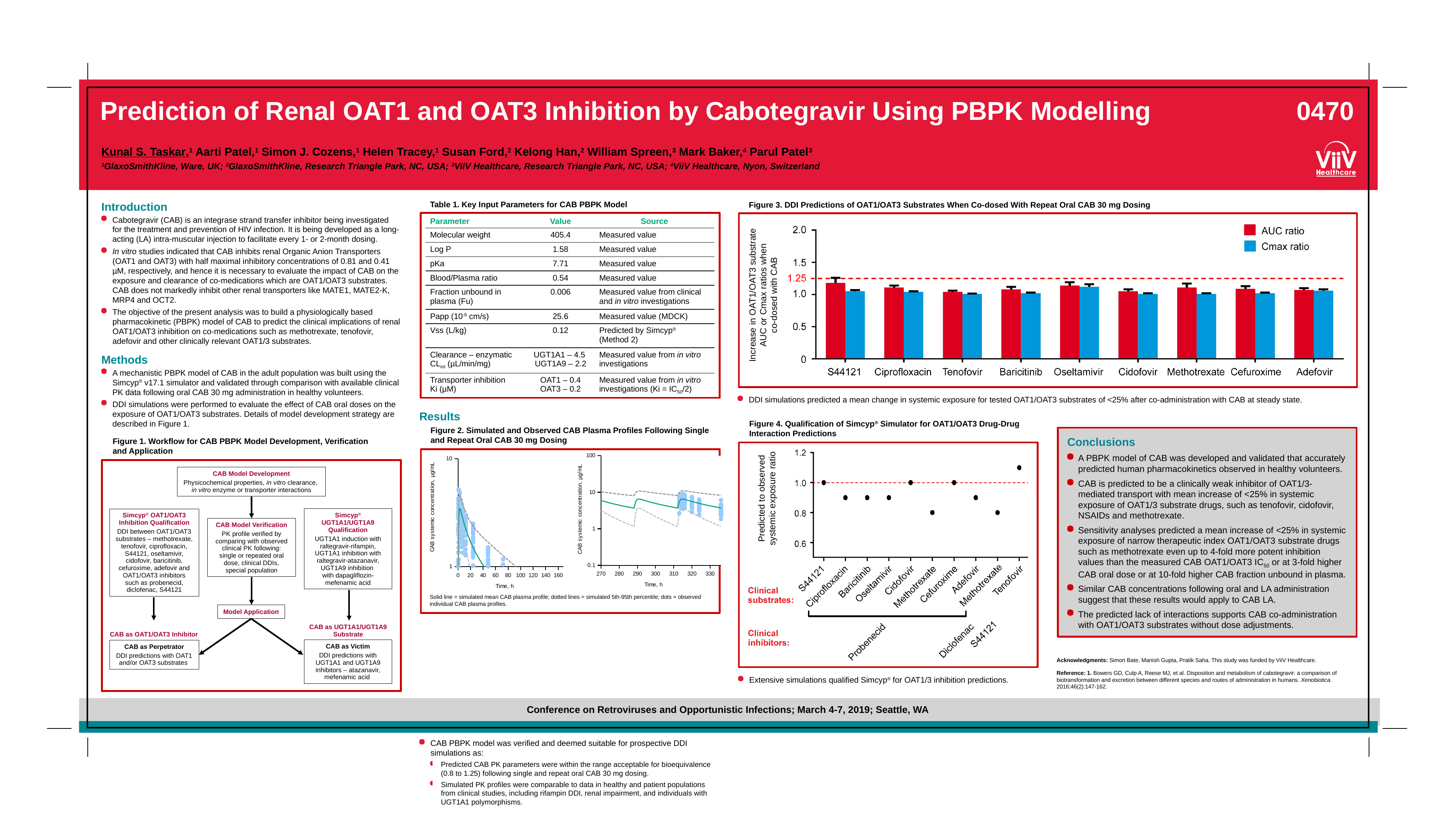
In Figure 4, which substrate has the highest predicted to observed systemic exposure ratio? Tenofovir In Figure 3, what value does the red dashed horizontal line mark on the y axis? 1.25 In Figure 3, is the AUC ratio for S44121 greater or less than 1.5? less In Figure 3, which colour represents the Cmax ratio? blue In Figure 3, how many series does the legend list? 2 What kind of chart is Figure 3? bar chart In Figure 4, what is the predicted to observed systemic exposure ratio for Cidofovir? 1.0 In Figure 4, is the value for Tenofovir greater or less than 1.0? greater In Figure 4, how many data points are plotted? 10 In Figure 3, how many substrates are shown on the x axis? 9 In Figure 3, is the AUC ratio for S44121 greater or less than 1.0? greater In Figure 3, which is larger for S44121, the AUC ratio or the Cmax ratio? AUC ratio